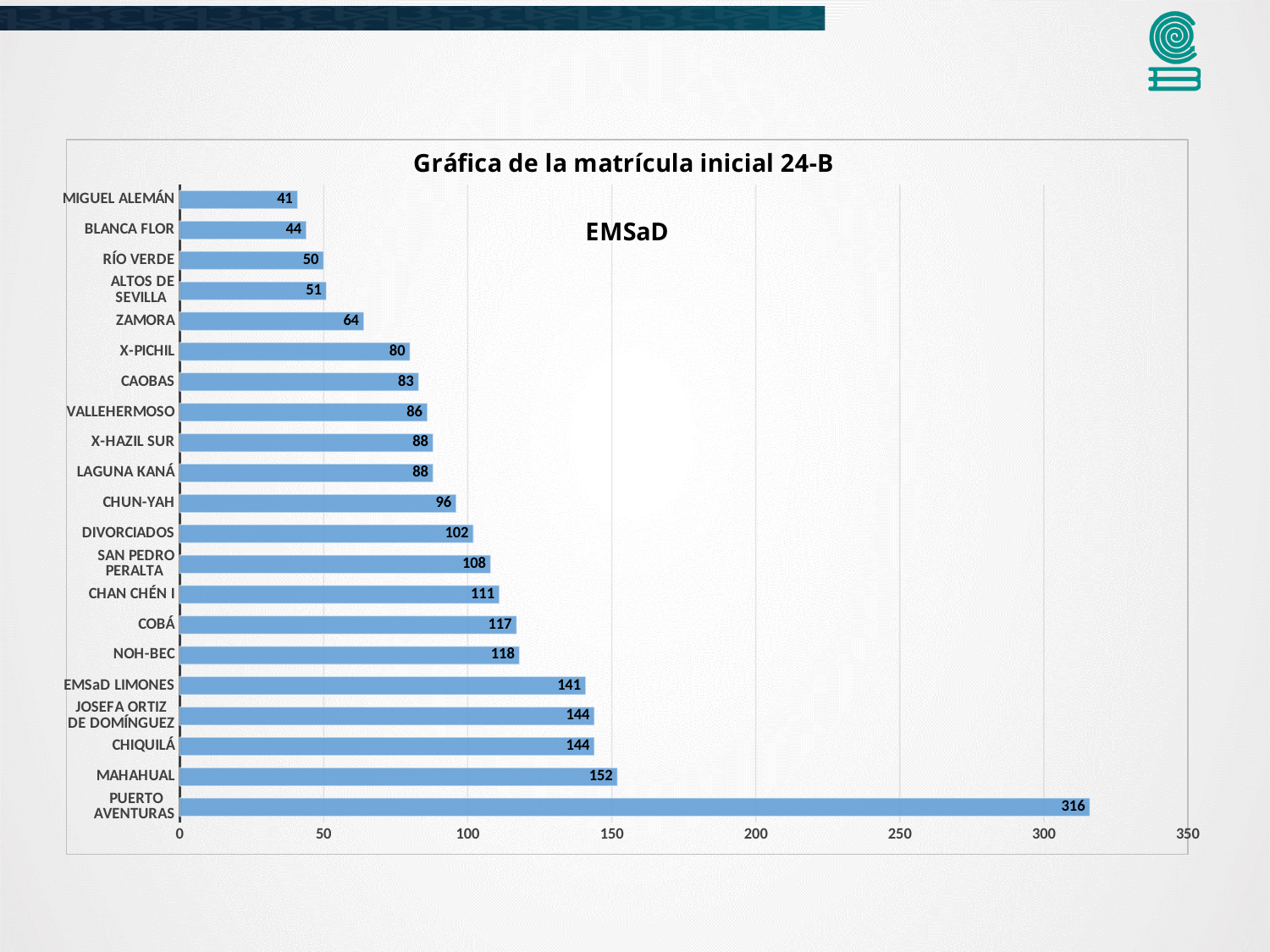
Is the value for MAHAHUAL greater or less than 100? greater What is the value for ZAMORA? 64 Which category has the lowest value? MIGUEL ALEMÁN How many categories are shown in the chart? 21 What is the value for PUERTO AVENTURAS? 316 What is the difference between the values for NOH-BEC and COBÁ? 1 What kind of chart is shown on the slide? bar chart What is the title of the chart? Gráfica de la matrícula inicial 24-B Which category has the highest value? PUERTO AVENTURAS Which is larger, the value for CHUN-YAH or the value for CAOBAS? CHUN-YAH What is the value for EMSaD LIMONES? 141 What is the difference between the values for PUERTO AVENTURAS and MAHAHUAL? 164